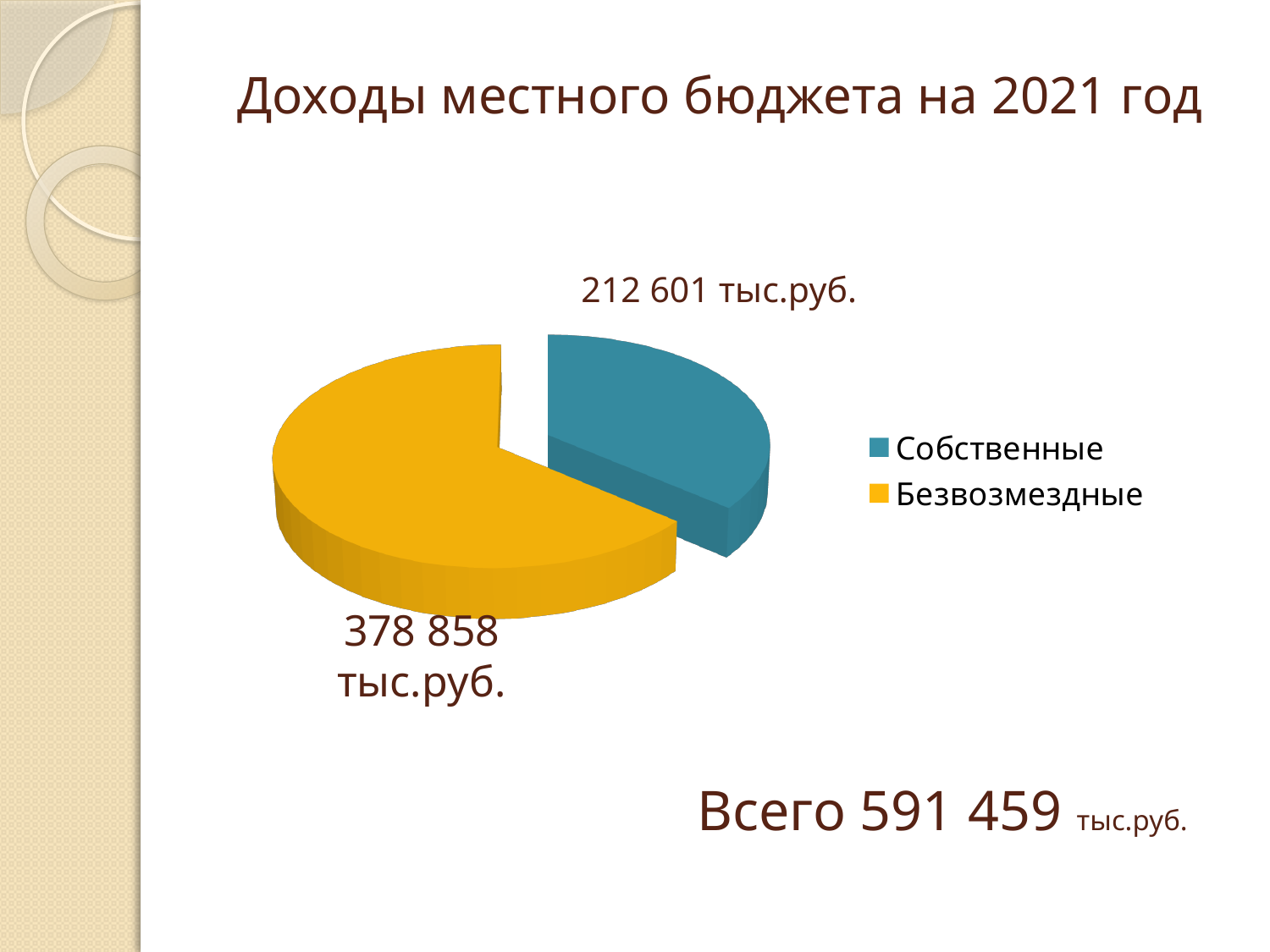
Which category has the smallest slice of the pie? Собственные What is the total of the two slices shown on the slide? 591 459 тыс.руб. What is the value for Собственные? 212 601 тыс.руб. Which is larger, Собственные or Безвозмездные? Безвозмездные What is the value for Безвозмездные? 378 858 тыс.руб. What is the title of the slide? Доходы местного бюджета на 2021 год How many slices does the pie chart have? 2 To the nearest whole percent, what share of the total does Безвозмездные make up? 64% How many entries does the legend list? 2 What is the difference between Безвозмездные and Собственные? 166 257 тыс.руб. Which category has the largest slice of the pie? Безвозмездные What type of chart is shown on the slide? pie chart